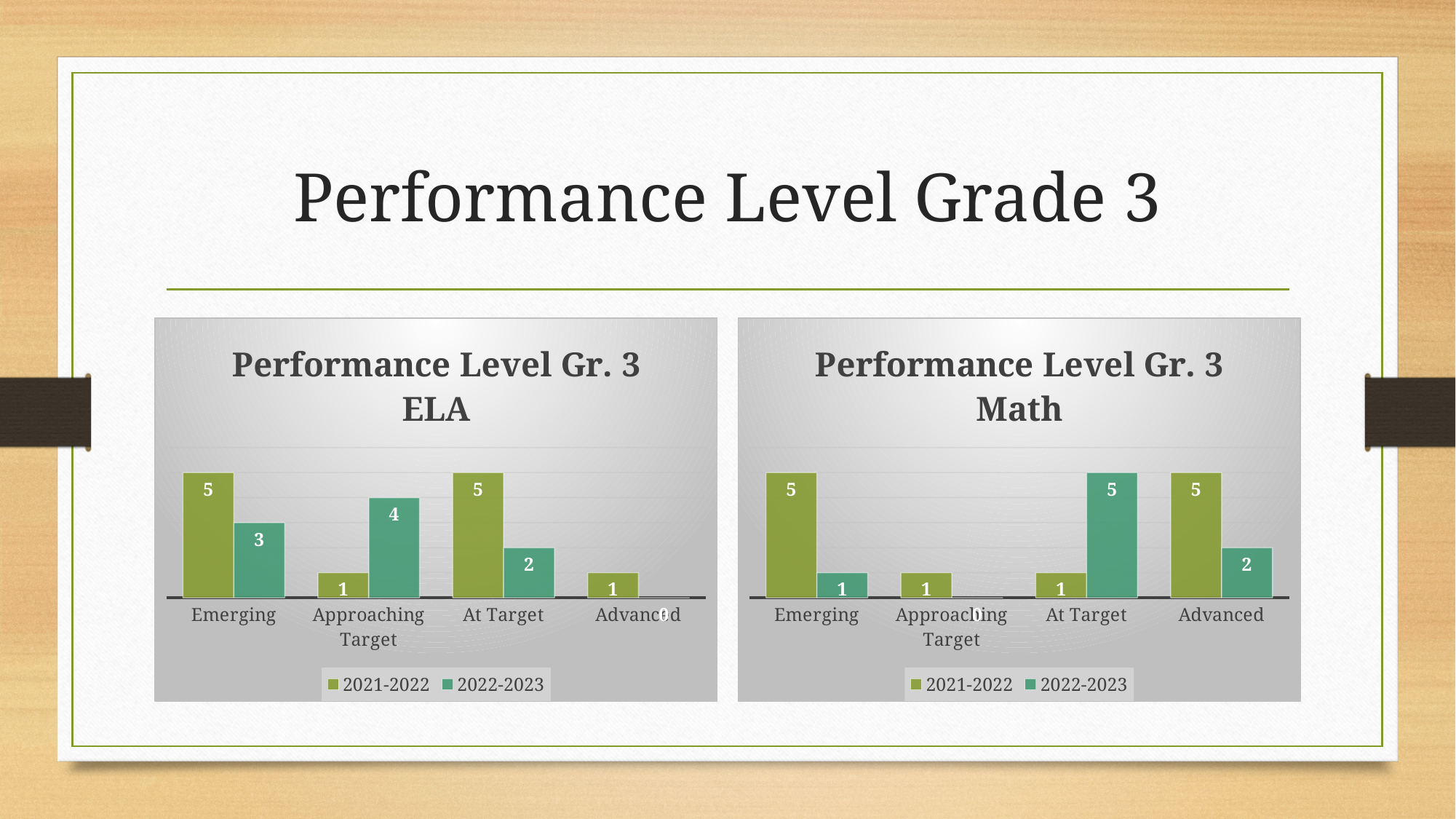
What kind of chart is the Performance Level Gr. 3 Math chart? Bar chart In the Performance Level Gr. 3 Math chart, what is the value for At Target in 2022-2023? 5 In the Performance Level Gr. 3 Math chart, which category has the lowest value for 2022-2023? Approaching Target How many series does the legend of the Performance Level Gr. 3 Math chart list? 2 In the Performance Level Gr. 3 ELA chart, what is the difference between the 2021-2022 and 2022-2023 values for Emerging? 2 How many categories are shown on the x axis of the Performance Level Gr. 3 ELA chart? 4 In the Performance Level Gr. 3 Math chart, which is larger for At Target: 2021-2022 or 2022-2023? 2022-2023 In the Performance Level Gr. 3 ELA chart, what is the value for At Target in 2021-2022? 5 In the Performance Level Gr. 3 Math chart, what is the value for Advanced in 2022-2023? 2 In the Performance Level Gr. 3 ELA chart, what is the value for Approaching Target in 2022-2023? 4 In the Performance Level Gr. 3 ELA chart, which category has the highest value for 2022-2023? Approaching Target In the Performance Level Gr. 3 Math chart, what is the difference between the 2021-2022 and 2022-2023 values for Emerging? 4